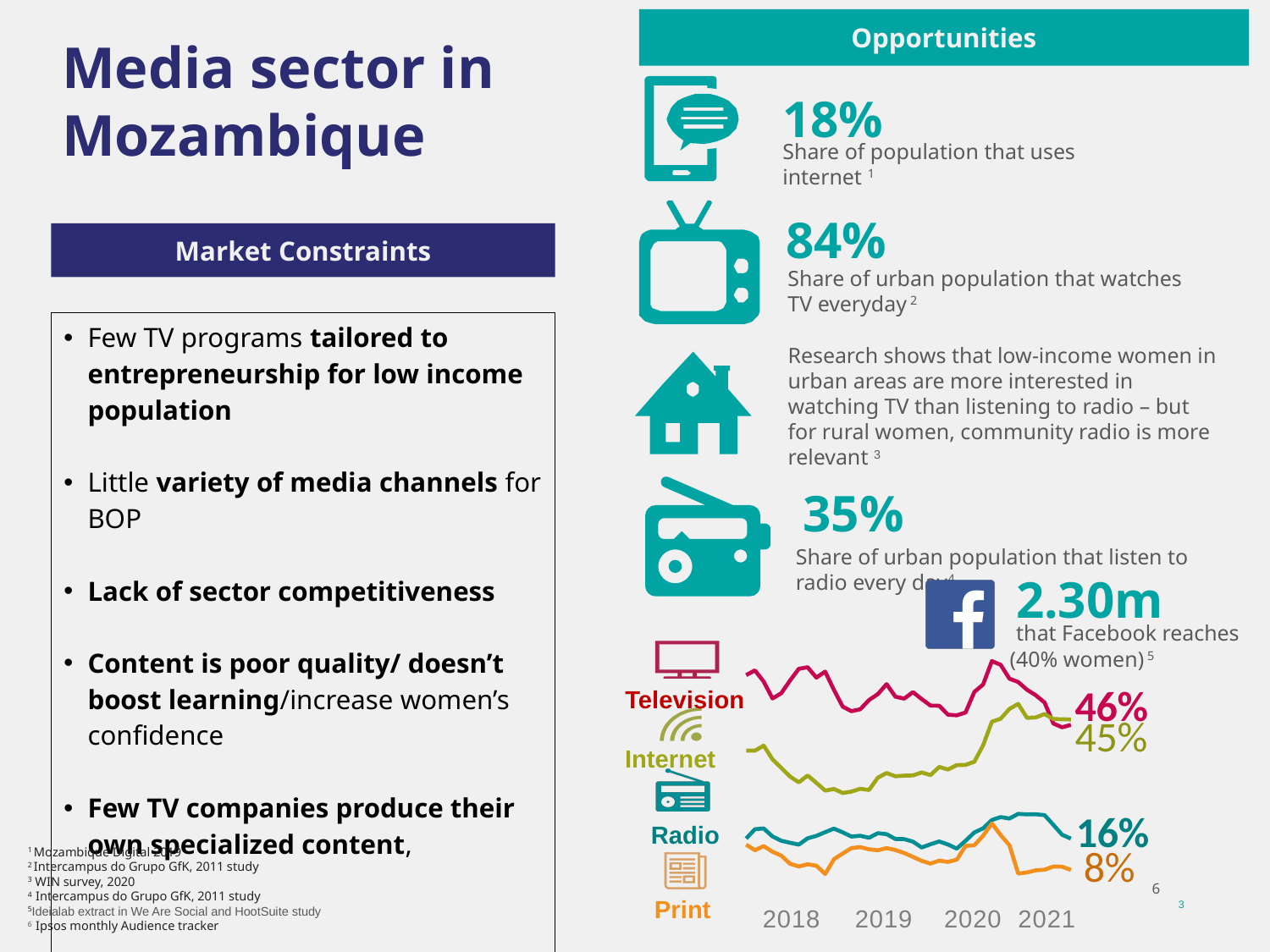
In the line chart, which has a larger final value, Radio or Print? Radio In the line chart, what is the final value shown for Print? 8% In the line chart, which media series has the lowest final value? Print How many media series are plotted in the line chart at the bottom right? 4 In the line chart, what is the final value shown for Internet? 45% What type of chart is shown at the bottom right of the slide? line chart In the line chart, what is the final value shown for Television? 46% What years are labelled on the x axis of the line chart? 2018, 2019, 2020, 2021 In the line chart, which media series has the highest final value? Television In the line chart, does the Internet series rise or fall from 2018 to 2021? rise In the line chart, what is the difference between the final values for Television and Print? 38 percentage points In the line chart, what is the final value shown for Radio? 16%